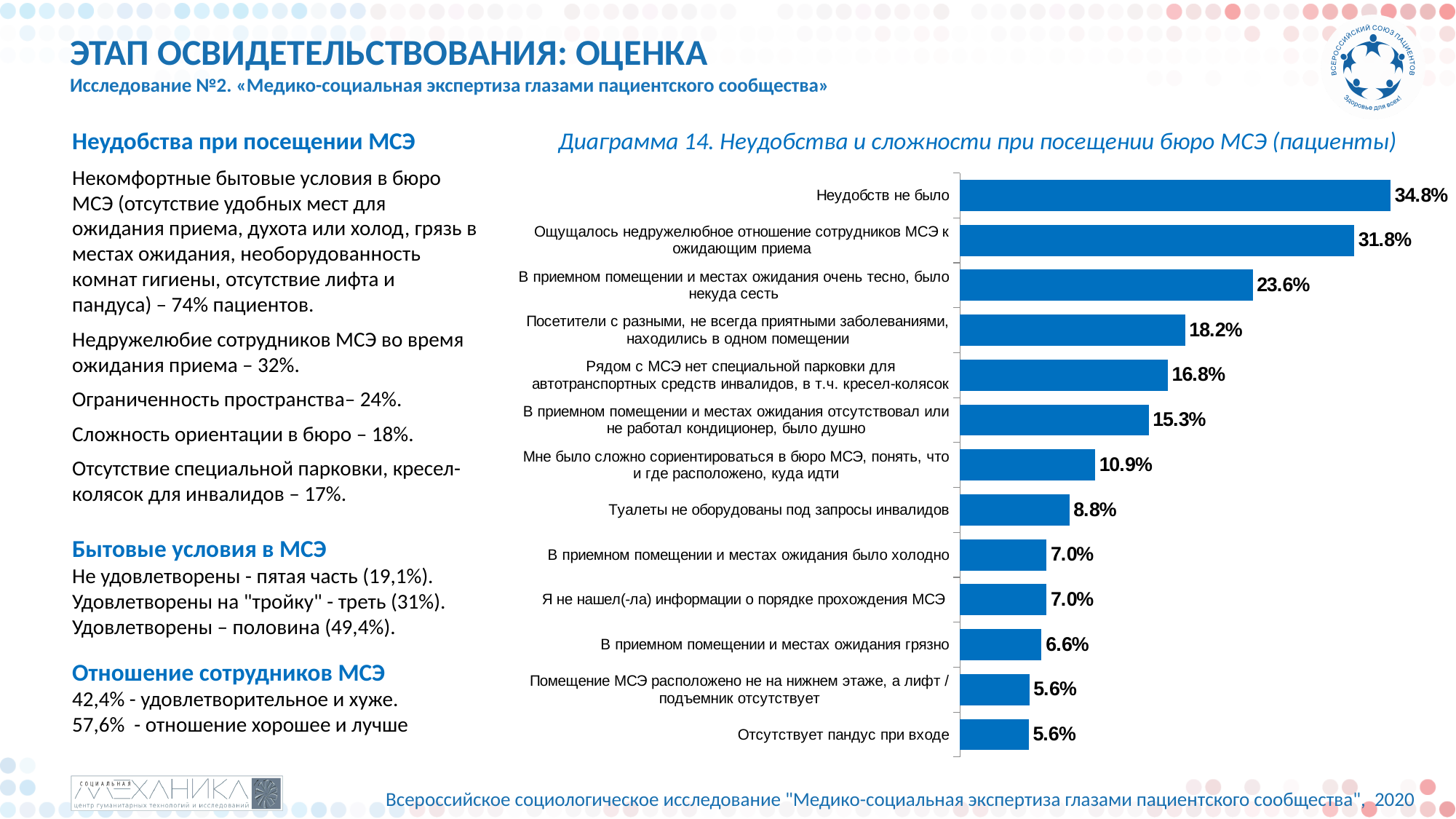
What is the value for «Мне было сложно сориентироваться в бюро МСЭ, понять, что и где расположено, куда идти»? 10.9% What is the title of the chart? Диаграмма 14. Неудобства и сложности при посещении бюро МСЭ (пациенты) What is the lowest value shown in the chart? 5.6% Which is larger: the value for «Рядом с МСЭ нет специальной парковки...» or for «...отсутствовал или не работал кондиционер, было душно»? Рядом с МСЭ нет специальной парковки (16.8%) Which category has the highest value in the chart? Неудобств не было How many categories are shown in the chart? 13 What is the value for «Неудобств не было»? 34.8% What is the difference between «В приемном помещении и местах ожидания очень тесно, было некуда сесть» and «Посетители с разными, не всегда приятными заболеваниями, находились в одном помещении»? 5.4 percentage points What is the difference between «Неудобств не было» and «Ощущалось недружелюбное отношение сотрудников МСЭ к ожидающим приема»? 3.0 percentage points What percentage is shown for «Туалеты не оборудованы под запросы инвалидов»? 8.8% What type of chart is shown on the slide? Horizontal bar chart What is the value for «Отсутствует пандус при входе»? 5.6%